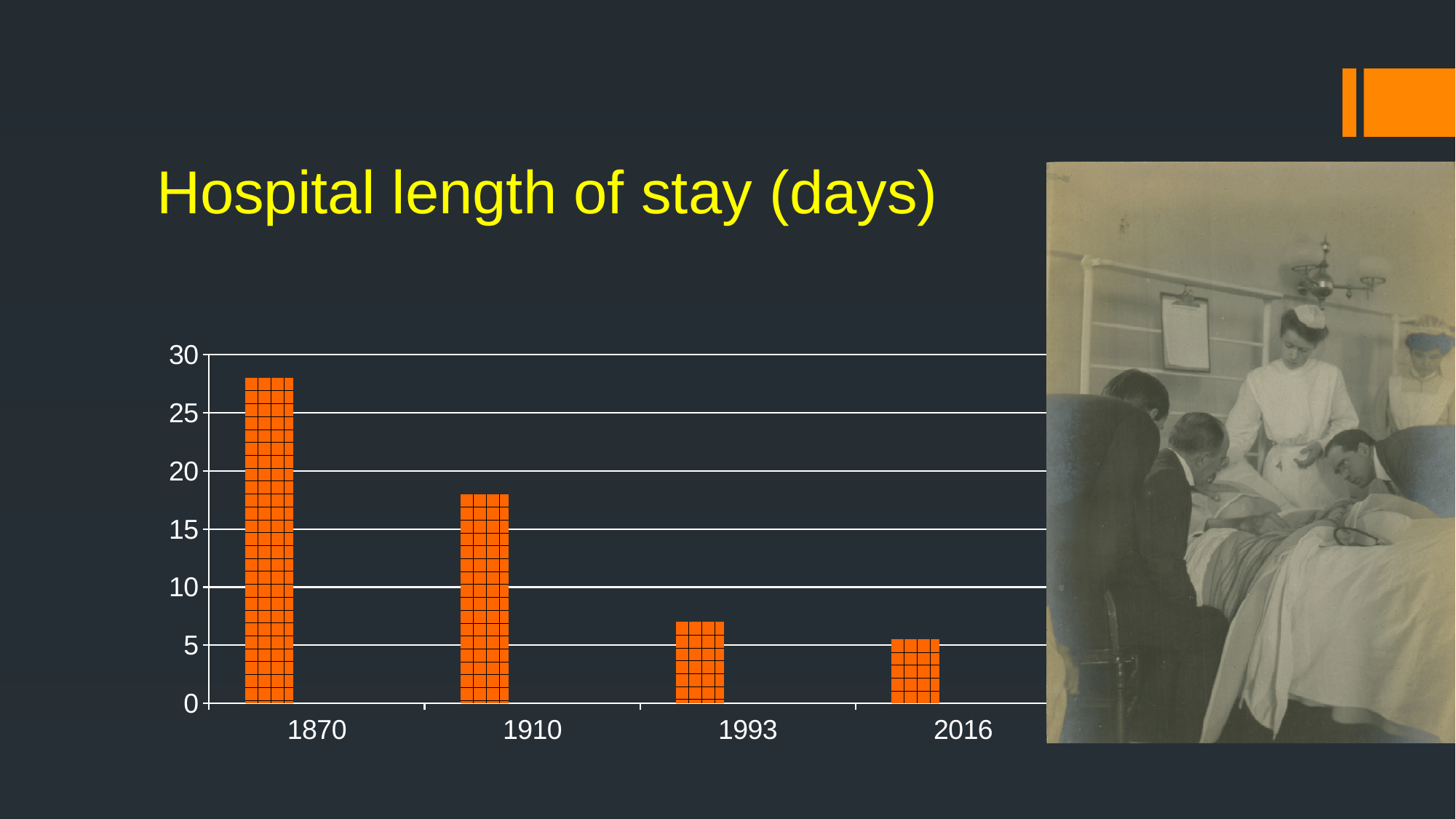
Is the hospital length of stay for 1870 greater or less than 25? greater Is the hospital length of stay for 1993 greater or less than 10? less Is the hospital length of stay for 1910 greater or less than 15? greater Which year has the shortest hospital length of stay? 2016 What kind of chart is shown on the slide? bar chart What is the title of the chart? Hospital length of stay (days) Which year has the longest hospital length of stay? 1870 Which year has a longer hospital length of stay, 1910 or 1993? 1910 Do the values rise or fall from 1870 to 2016 along the x axis? fall How many years are shown on the x axis of the chart? 4